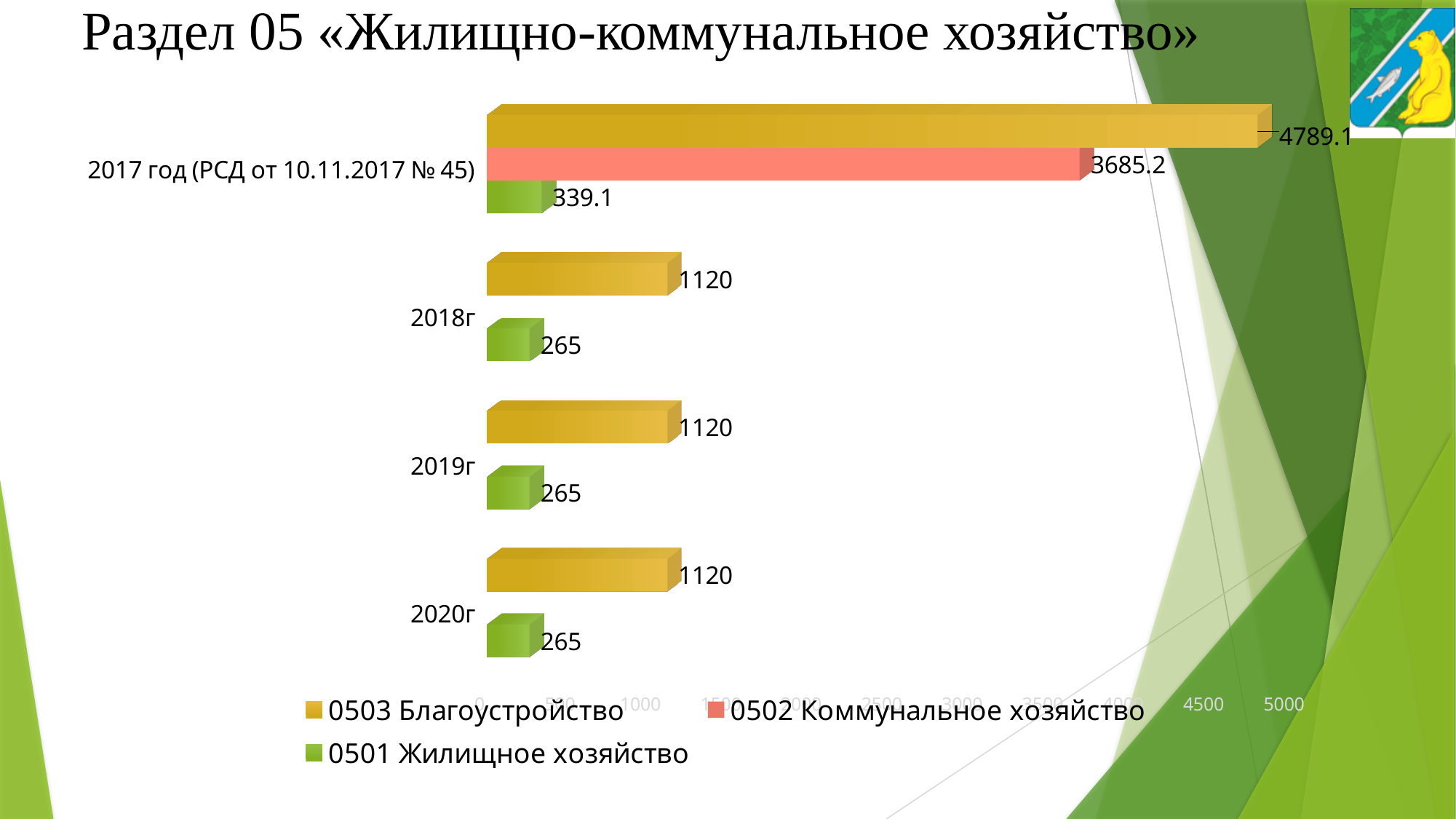
Which category has the highest value for 0503 Благоустройство? 2017 год (РСД от 10.11.2017 № 45) What is the value for 0501 Жилищное хозяйство in 2017 год (РСД от 10.11.2017 № 45)? 339.1 How many categories are shown on the chart? 4 What is the value for 0503 Благоустройство in 2017 год (РСД от 10.11.2017 № 45)? 4789.1 What is the difference between the 0503 Благоустройство and 0502 Коммунальное хозяйство values in 2017 год (РСД от 10.11.2017 № 45)? 1103.9 What is the value for 0503 Благоустройство in 2019г? 1120 What is the value for 0501 Жилищное хозяйство in 2020г? 265 What is the value for 0502 Коммунальное хозяйство in 2017 год (РСД от 10.11.2017 № 45)? 3685.2 How many series does the legend list? 3 Which is larger in 2017 год (РСД от 10.11.2017 № 45): 0502 Коммунальное хозяйство or 0501 Жилищное хозяйство? 0502 Коммунальное хозяйство What is the difference between the 0503 Благоустройство and 0501 Жилищное хозяйство values in 2018г? 855 What kind of chart is shown on the slide? Bar chart